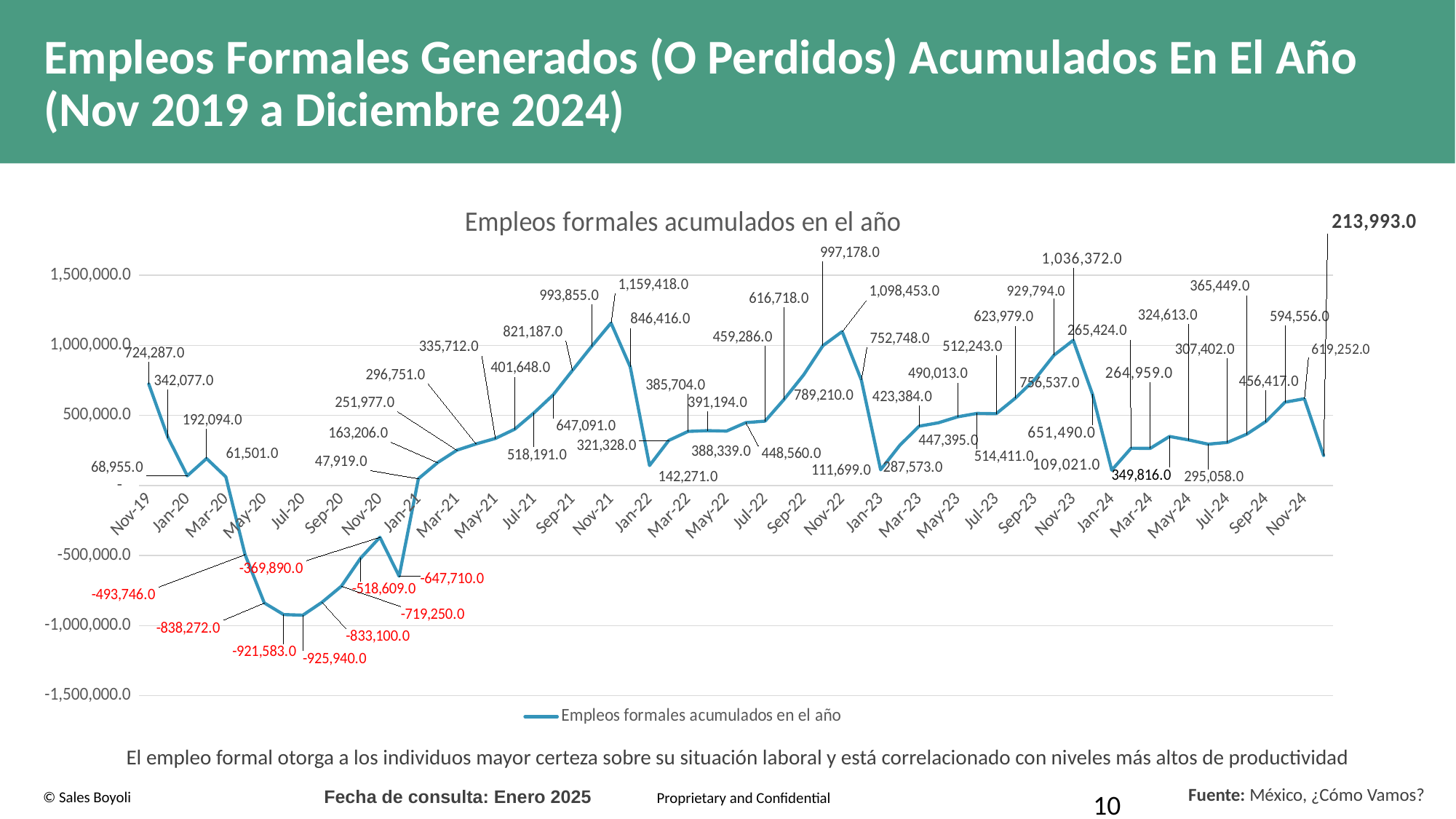
What is the value for Nov-19, the first point on the line? 724,287.0 What is the highest value plotted on the line? 1,159,418.0 What is the value for Jan-20? 68,955.0 What is the lowest value plotted on the line? -925,940.0 What is the legend entry for the plotted series? Empleos formales acumulados en el año What kind of chart is shown on the slide? line chart Which is larger, the peak of 1,159,418.0 in Nov-21 or the peak of 1,098,453.0 in Nov-22? 1,159,418.0 in Nov-21 Is the value for Nov-21 greater or less than 1,000,000.0? greater How many series does the legend list? 1 What is the value of the last point on the line (Dec-24)? 213,993.0 Does the line rise or fall between Mar-20 and Jul-20? fall What is the difference between the highest value (1,159,418.0) and the lowest value (-925,940.0) on the line? 2,085,358.0